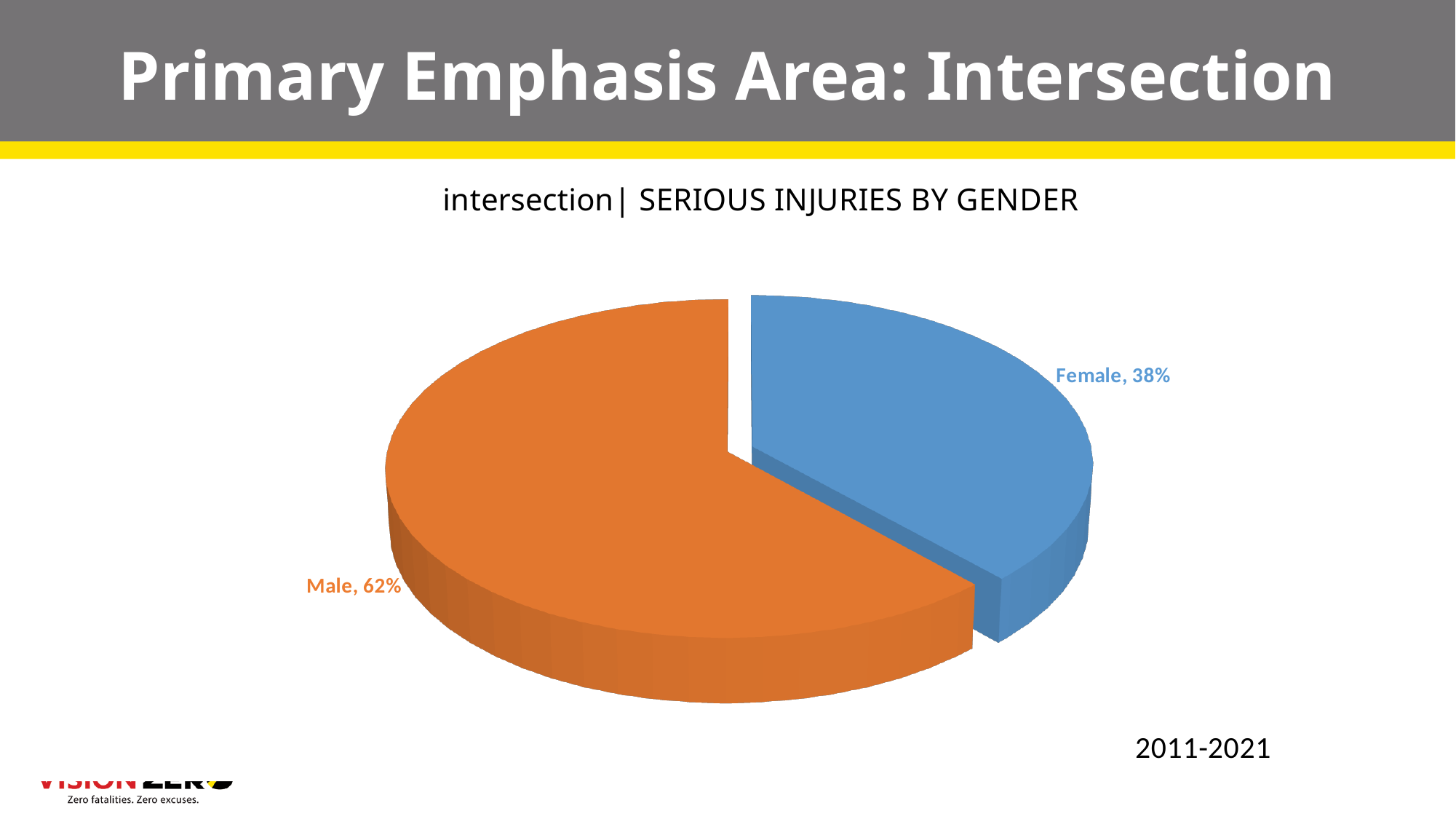
What share of serious injuries at intersections is attributed to females? 38% Which gender has the smaller share of serious injuries at intersections? Female What is the title of the chart? intersection| SERIOUS INJURIES BY GENDER Is the share for Male larger or smaller than the share for Female? larger What kind of chart is shown on the slide? Pie chart What share of serious injuries at intersections is attributed to males? 62% By how many percentage points does the male share exceed the female share? 24 percentage points Which gender has the larger share of serious injuries at intersections? Male How many slices does the pie chart have? 2 Is the share for Female greater or less than 50%? less What time period does the chart cover? 2011-2021